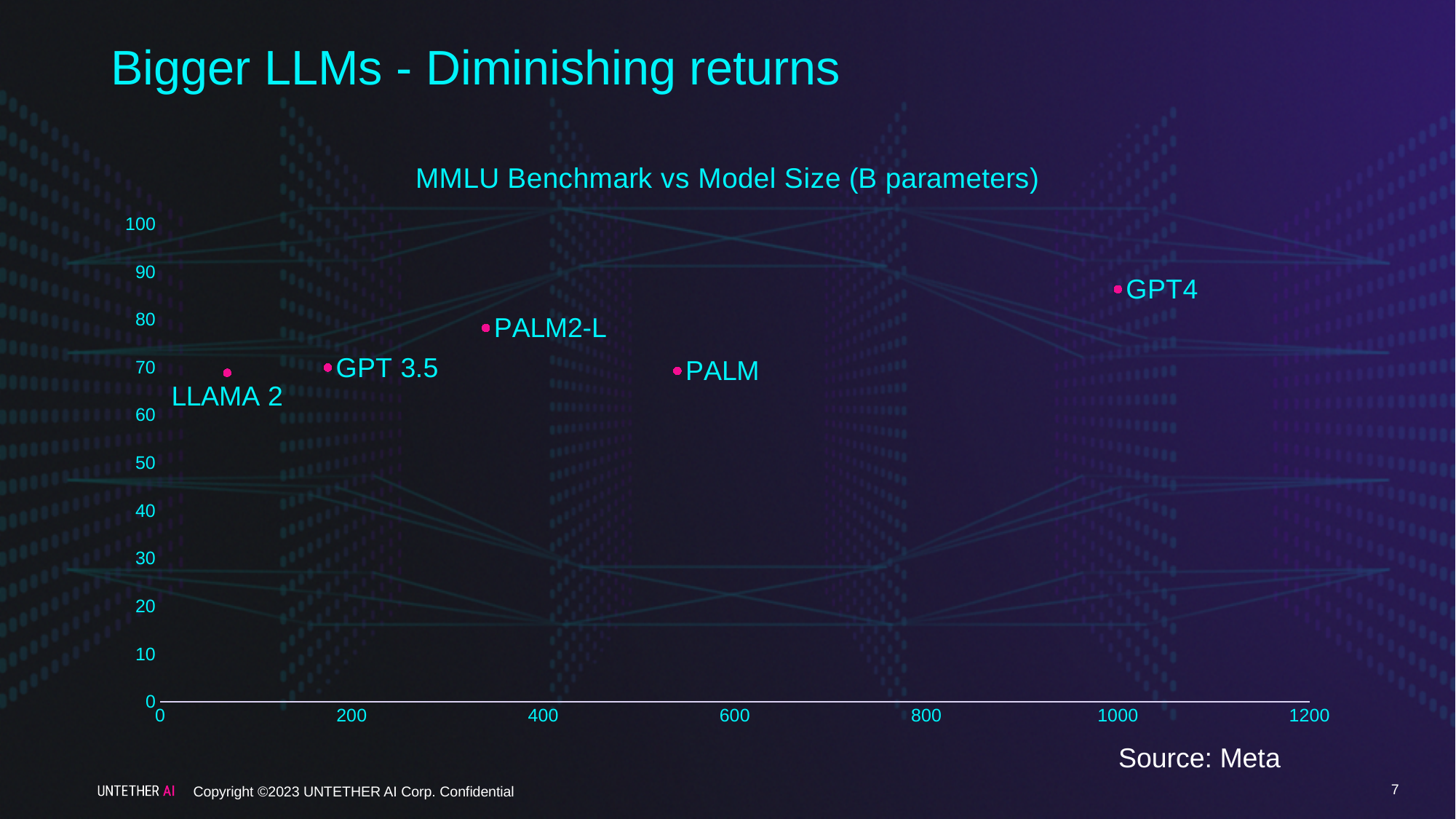
What is the title of the chart? MMLU Benchmark vs Model Size (B parameters) Is the MMLU score for LLAMA 2 greater or less than 80? less How many models are plotted on the chart? 5 What kind of chart is shown on the slide? scatter chart Which has the higher MMLU score, GPT4 or GPT 3.5? GPT4 Is the MMLU score for PALM2-L greater or less than 70? greater Which model has the highest MMLU benchmark score on the chart? GPT4 Which has the higher MMLU score, PALM2-L or PALM? PALM2-L Is the MMLU score for GPT4 greater or less than 80? greater Which model is plotted with the largest model size (furthest right on the x axis)? GPT4